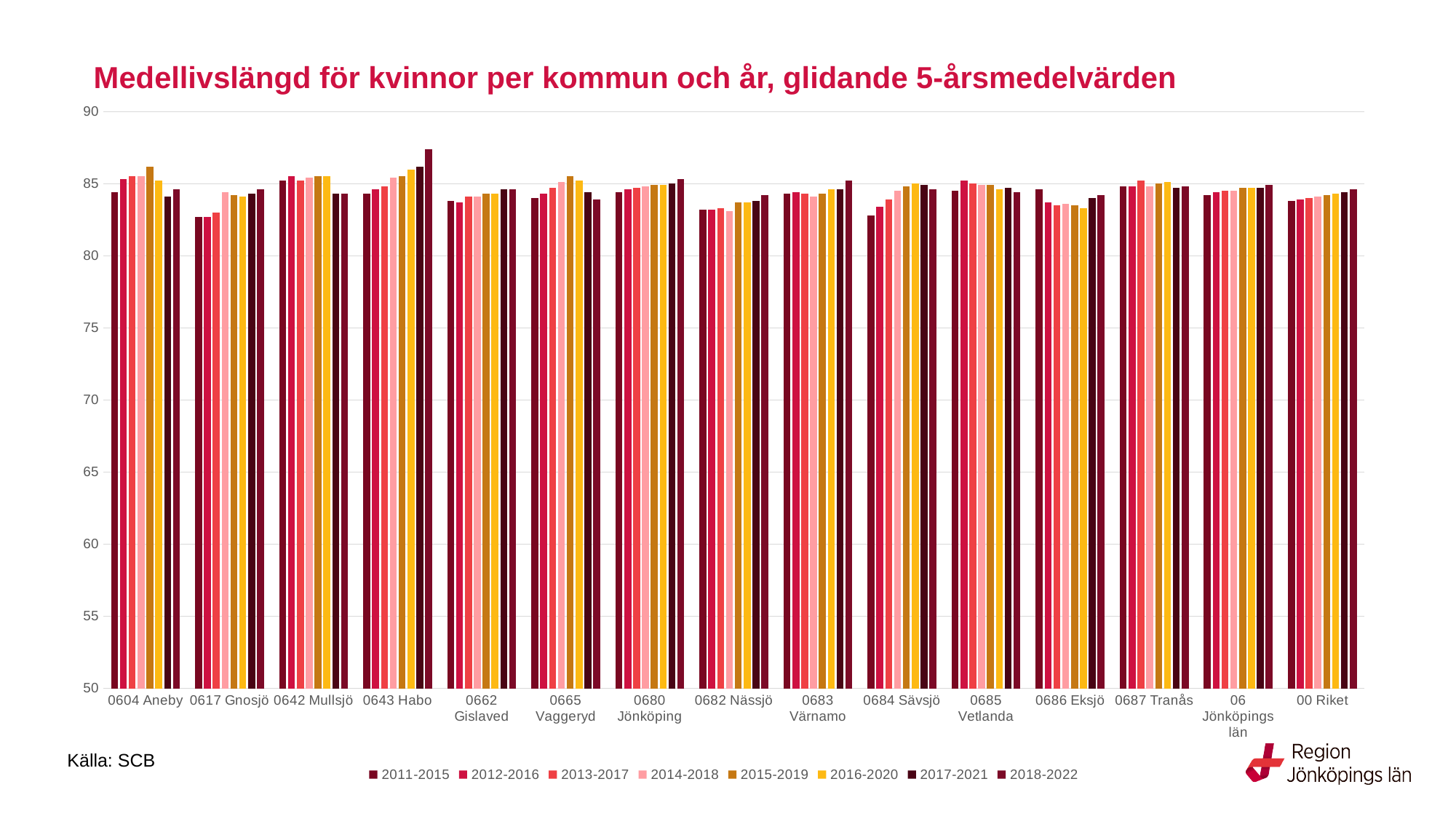
How many series does the legend list? 8 Is the 2011-2015 value for 0617 Gnosjö greater or less than 85? less What kind of chart is shown on the slide? Bar chart What source is cited for the chart data? SCB Which is larger, the 2018-2022 value for 0643 Habo or the 2018-2022 value for 0617 Gnosjö? 0643 Habo Is the 2018-2022 value for 0643 Habo greater or less than 85? greater Do the values for 0643 Habo rise or fall from 2011-2015 to 2018-2022? rise Is the 2015-2019 value for 0604 Aneby greater or less than 85? greater What is the title of the chart? Medellivslängd för kvinnor per kommun och år, glidande 5-årsmedelvärden How many municipalities/regions are shown along the x axis? 15 Which category and period has the highest bar in the chart? 0643 Habo, 2018-2022